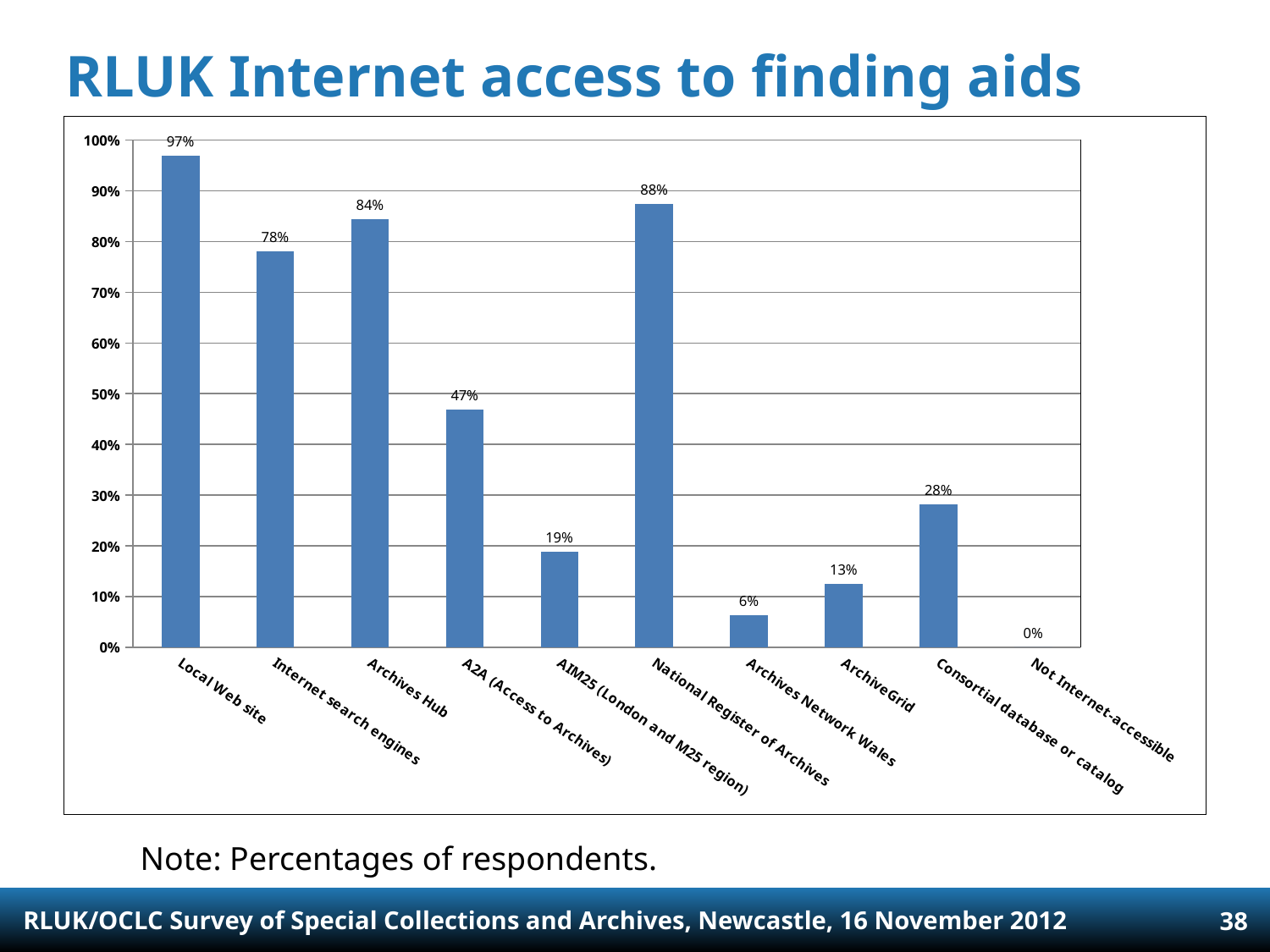
What is the title of the chart? RLUK Internet access to finding aids What is the difference between the values for National Register of Archives and Archives Hub? 4% Which category has the lowest value? Not Internet-accessible What is the value for Local Web site? 97% What is the value for A2A (Access to Archives)? 47% What is the value for Archives Network Wales? 6% Is the value for ArchiveGrid greater or less than 20%? less Which is larger, the value for Internet search engines or the value for AIM25 (London and M25 region)? Internet search engines Which category has the highest value? Local Web site How many categories are shown on the x axis? 10 What kind of chart is shown on the slide? bar chart What is the value for Consortial database or catalog? 28%